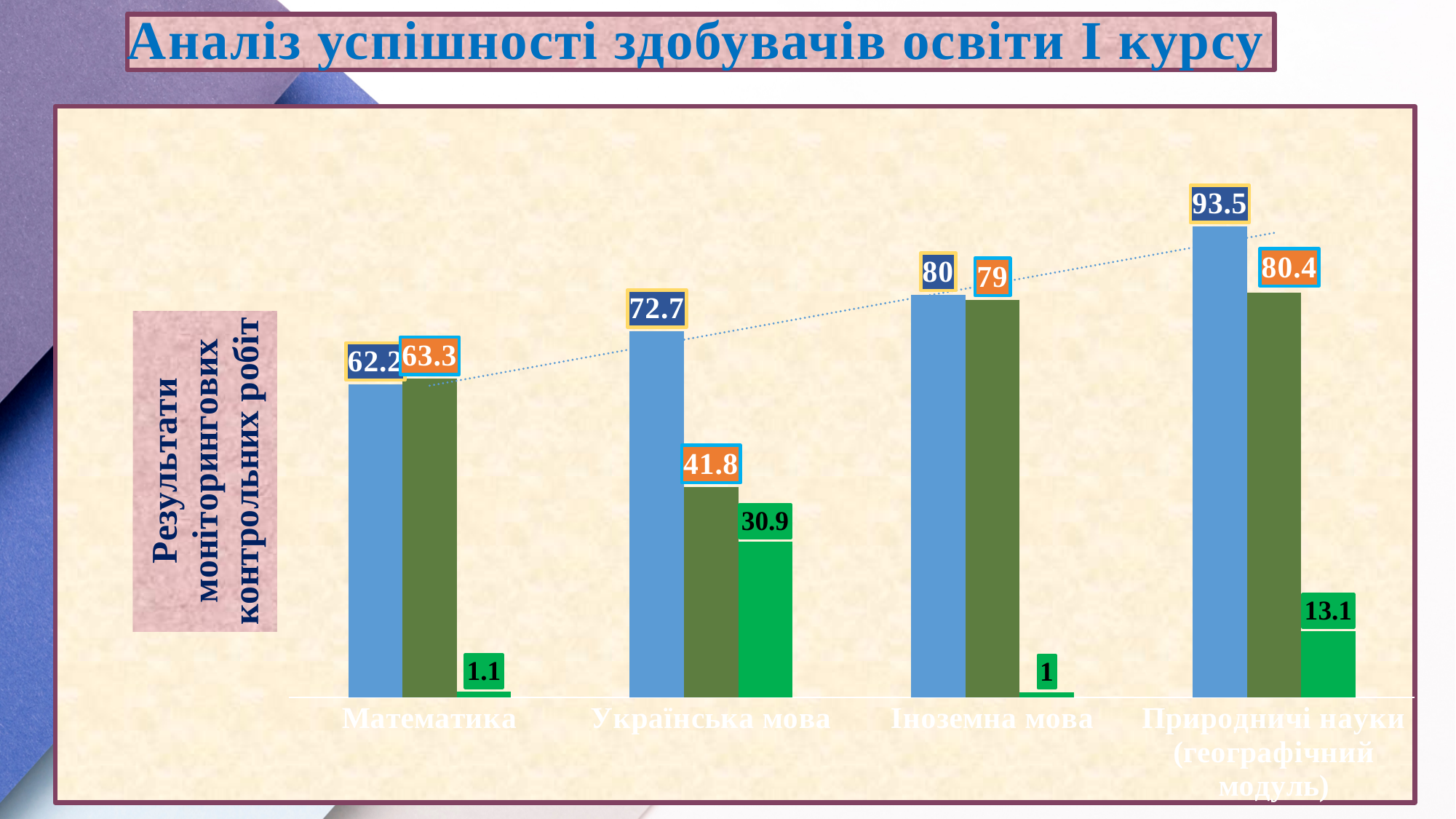
What is the value of the bright green bar for Природничі науки (географічний модуль)? 13.1 How many categories are shown on the x axis? 4 What kind of chart is shown on the slide? bar chart Which is larger for Математика: the blue bar or the dark green bar? the dark green bar What is the value of the dark green bar for Іноземна мова? 79 What is the difference between the blue bar and the dark green bar for Українська мова? 30.9 Do the blue bar values rise or fall from Математика to Природничі науки (географічний модуль)? rise Which category has the lowest bright green bar? Іноземна мова What is the value of the blue bar for Математика? 62.2 What is the value of the dark green bar for Українська мова? 41.8 Which category has the highest blue bar? Природничі науки (географічний модуль) How many bars are shown for each category? 3